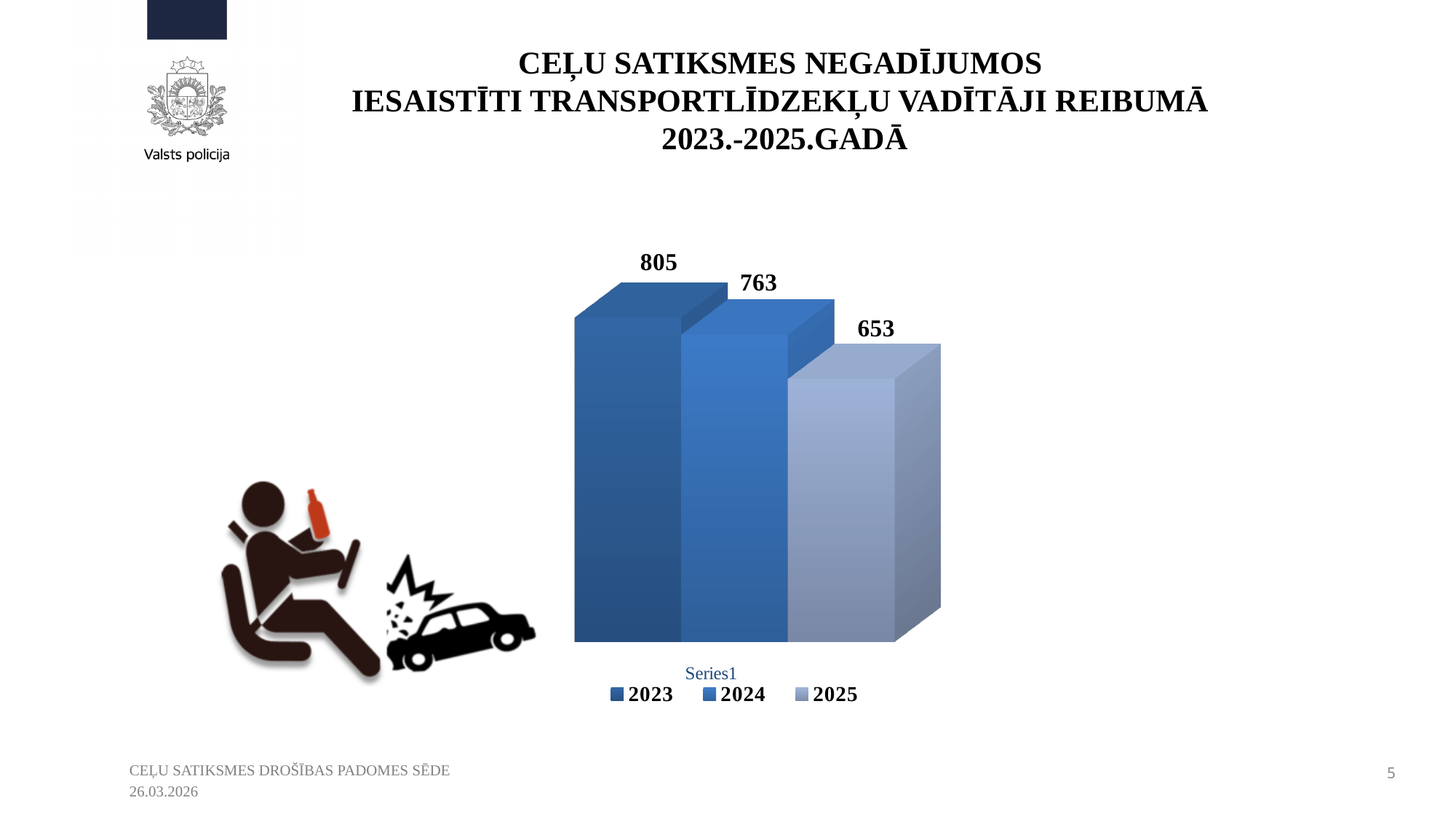
How many entries does the legend list? 3 What is the value for 2025? 653 What is the value for 2023? 805 What is the difference between the values for 2023 and 2024? 42 Which year has the highest value? 2023 How many bars are shown in the chart? 3 Do the values rise or fall from 2023 to 2025? Fall What is the value for 2024? 763 Which year has the lowest value? 2025 What kind of chart is shown on the slide? Bar chart What is the difference between the values for 2023 and 2025? 152 Which is larger, the value for 2024 or the value for 2025? 2024